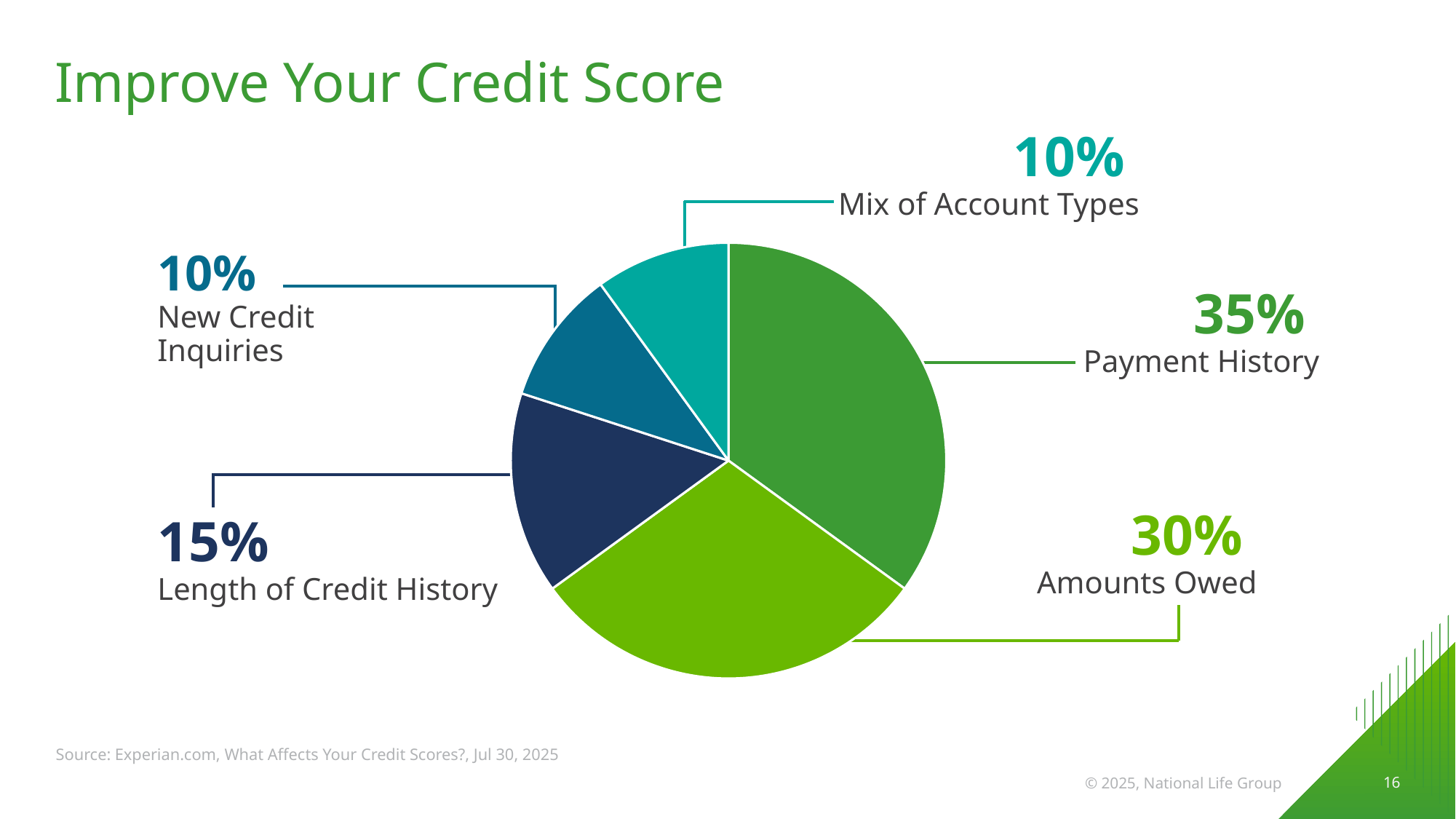
What percentage is shown for Mix of Account Types? 10% What percentage is shown for New Credit Inquiries? 10% How many categories are shown in the pie chart? 5 What is the difference in percentage points between Payment History and Amounts Owed? 5 What percentage is shown for Length of Credit History? 15% What share of the pie does Payment History represent? 35% What percentage is shown for Amounts Owed? 30% Which is larger, Amounts Owed or Length of Credit History? Amounts Owed What kind of chart is shown on the slide? Pie chart Which category has the largest slice of the pie? Payment History Which category has the largest share after Payment History? Amounts Owed What is the difference in percentage points between Length of Credit History and New Credit Inquiries? 5